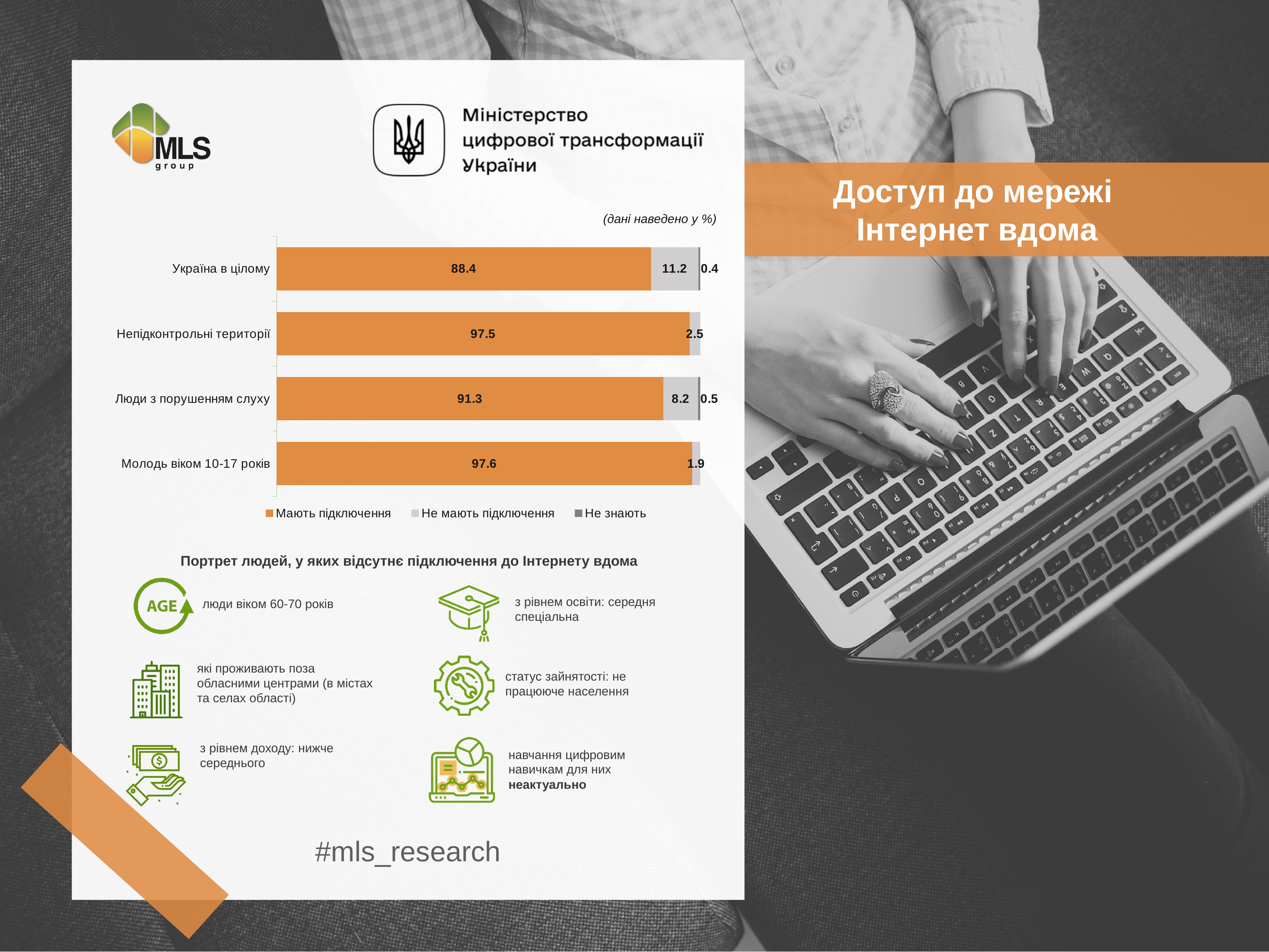
Which category has the highest value for "Не мають підключення"? Україна в цілому What is the value of "Не мають підключення" for "Люди з порушенням слуху"? 8.2 How many series does the legend list? 3 What is the total of the stacked bar for "Україна в цілому"? 100 What is the value of "Мають підключення" for "Молодь віком 10-17 років"? 97.6 What kind of chart is shown on the slide? Stacked bar chart What is the value of "Мають підключення" for "Україна в цілому"? 88.4 How many categories are shown in the chart? 4 Which category has the lowest value for "Мають підключення"? Україна в цілому What is the difference between the "Не мають підключення" values for "Україна в цілому" and "Люди з порушенням слуху"? 3.0 Which has a larger "Мають підключення" value: "Люди з порушенням слуху" or "Україна в цілому"? Люди з порушенням слуху What is the value of "Не знають" for "Україна в цілому"? 0.4